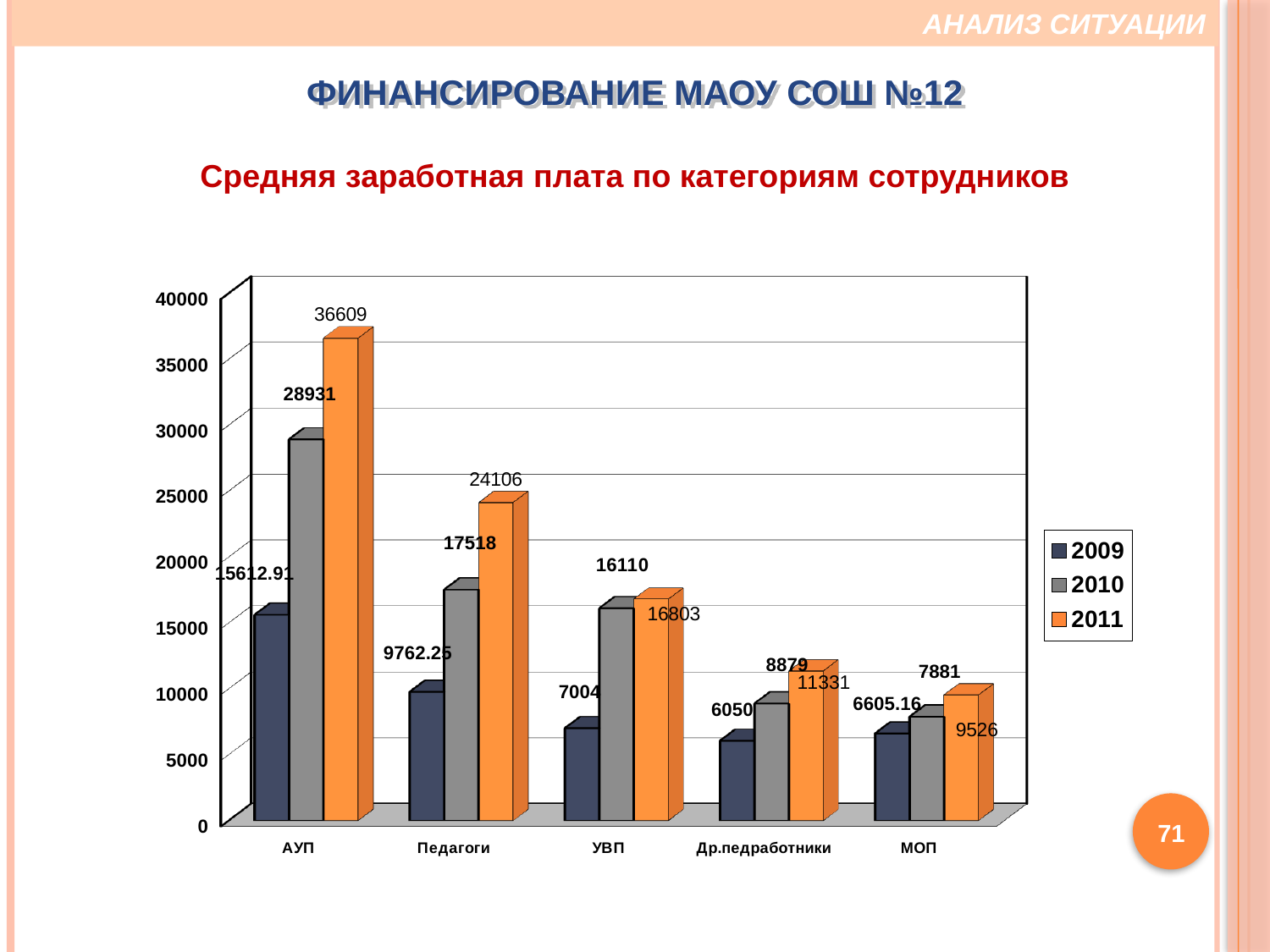
Which category has the lowest value in 2009? Др.педработники What is the value for МОП in 2011? 9526 Which category has the highest value in 2011? АУП What is the value for УВП in 2010? 16110 How many series does the legend list? 3 What is the difference between the 2011 and 2010 values for Педагоги? 6588 Which is larger: the 2010 value for Др.педработники or the 2010 value for МОП? Др.педработники What is the value for Педагоги in 2009? 9762.25 What kind of chart is shown on the slide? bar chart Do the values for АУП rise or fall from 2009 to 2011? rise How many employee categories are shown on the x axis? 5 What is the value for АУП in 2011? 36609